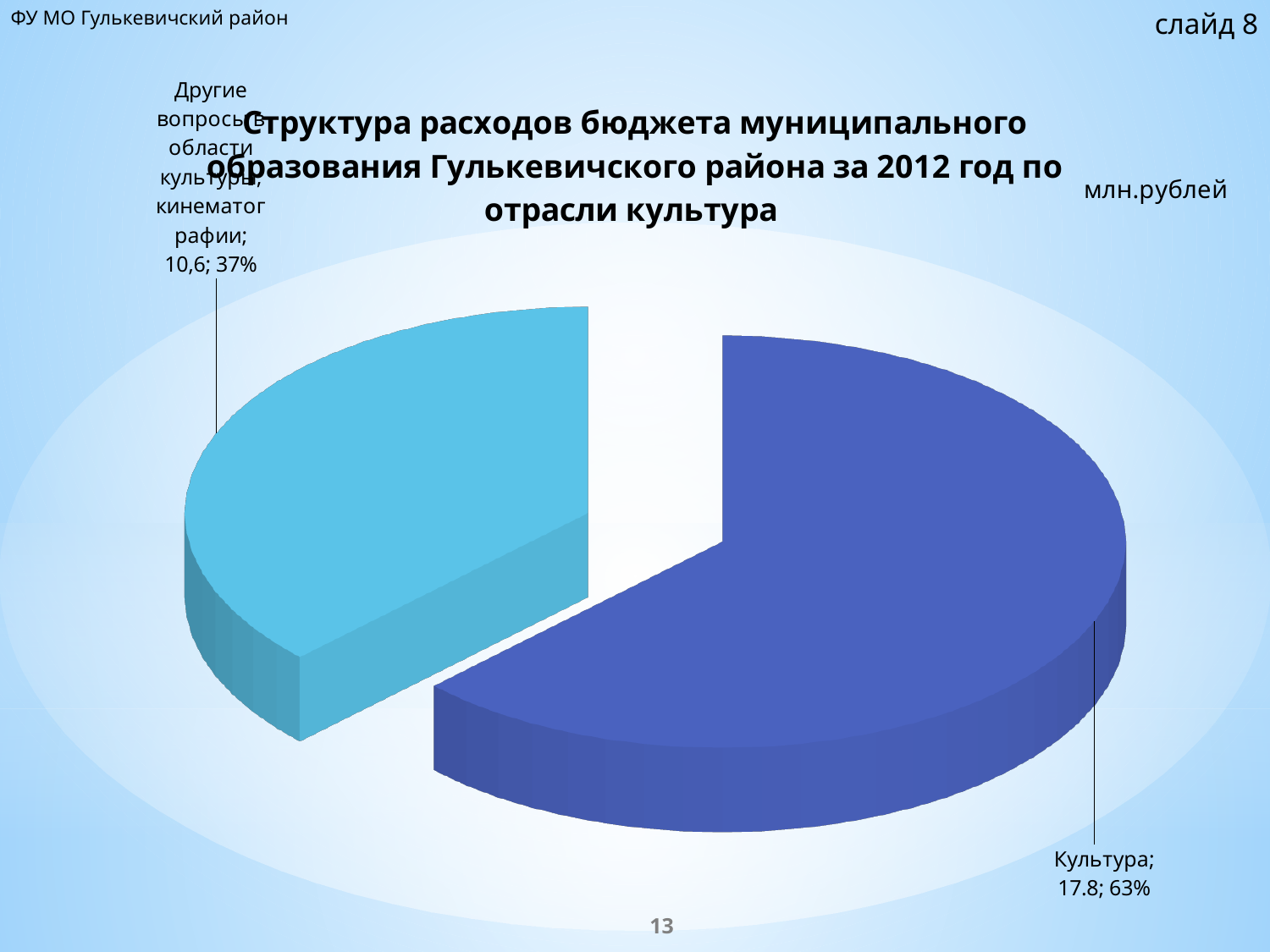
What unit of measurement is indicated on the slide for the chart values? млн.рублей What kind of chart is shown on the slide? pie chart Which slice is the largest? Культура Which is larger: Культура or Другие вопросы в области культуры, кинематографии? Культура Which slice is the smallest? Другие вопросы в области культуры, кинематографии What year does the chart title refer to? 2012 What share of the pie does the Другие вопросы в области культуры, кинематографии slice represent? 37% What is the value for Культура? 17.8 What share of the pie does the Культура slice represent? 63% How many slices does the pie chart have? 2 What is the difference between the value for Культура and the value for Другие вопросы в области культуры, кинематографии? 7.2 What is the value for Другие вопросы в области культуры, кинематографии? 10,6